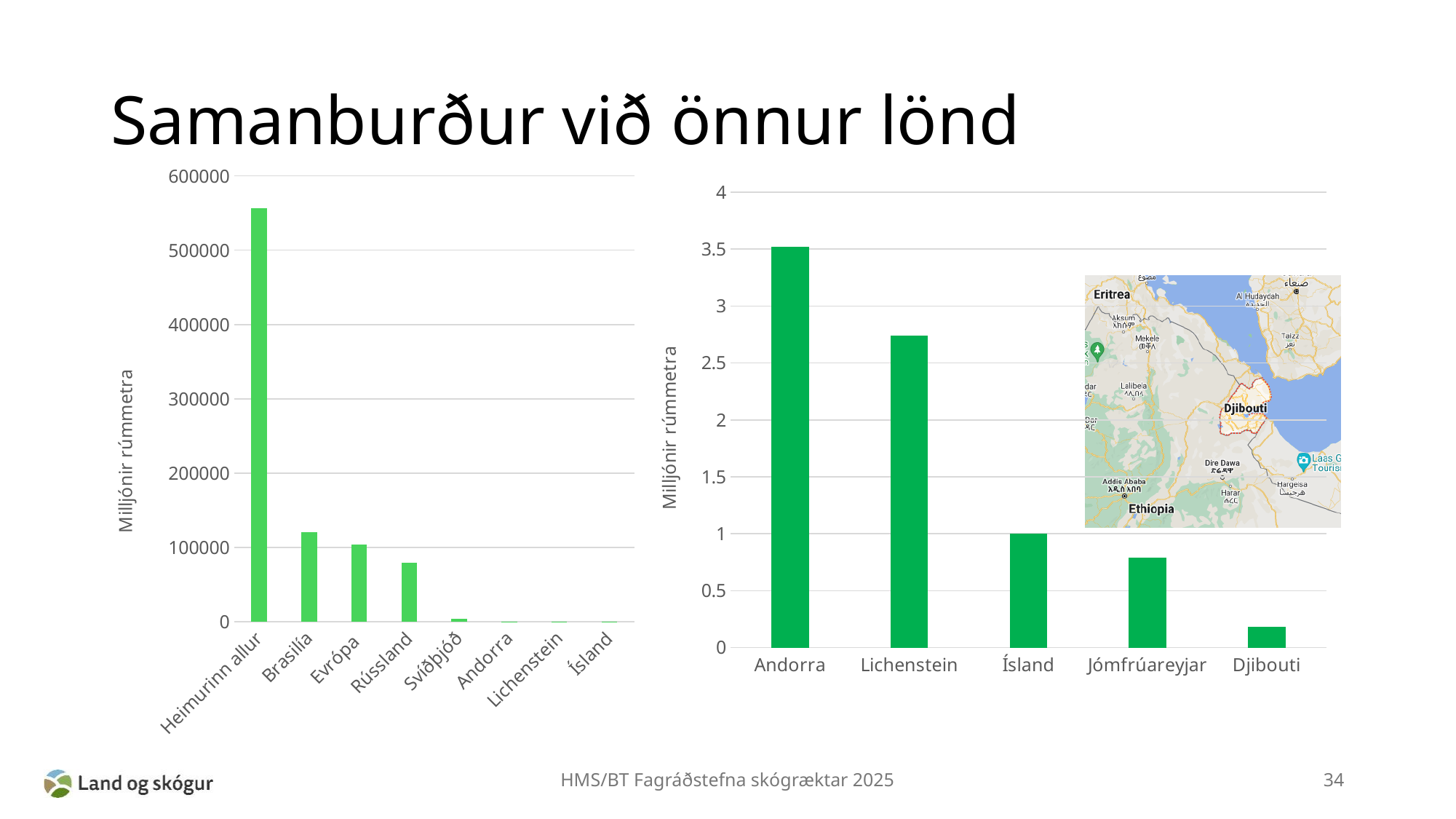
On the right chart, is the value for Lichenstein greater or less than 3? less What kind of chart is the chart on the left side of the slide? bar chart How many categories are shown on the left chart? 8 How many categories are shown on the right chart? 5 On the left chart, is the value for Rússland greater or less than 100000? less On the left chart, which is larger, the value for Brasilía or the value for Evrópa? Brasilía On the left chart, is the value for Brasilía greater or less than 100000? greater On the right chart, do the values rise or fall from left to right along the x axis? fall On the right chart, which category has the highest value? Andorra On the right chart, which category has the lowest value? Djibouti What is the y-axis label of the left chart? Milljónir rúmmetra On the left chart, which category has the highest value? Heimurinn allur